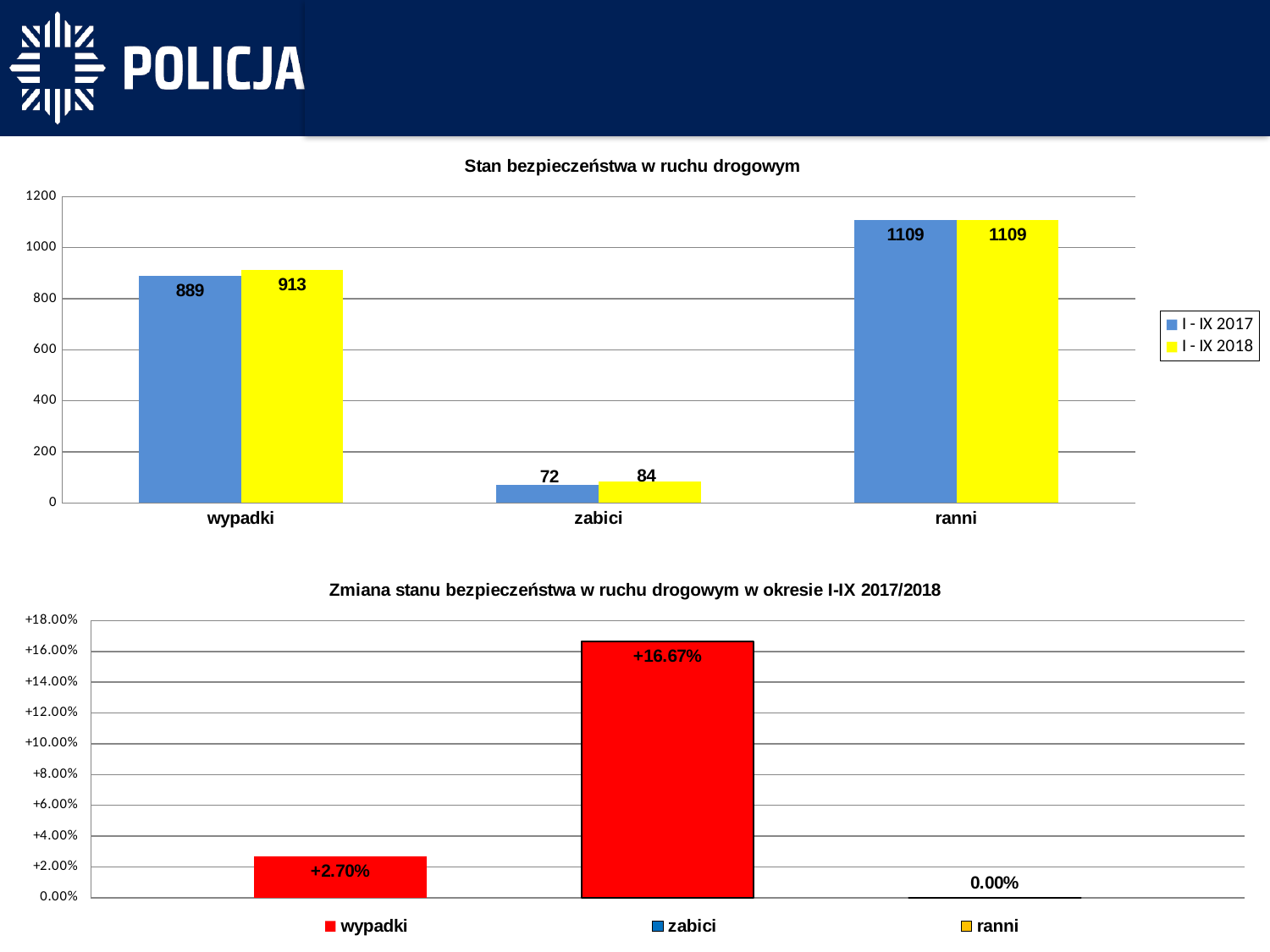
In the chart titled 'Stan bezpieczeństwa w ruchu drogowym', which category has the lowest value in the 'I - IX 2018' series? zabici In the chart titled 'Stan bezpieczeństwa w ruchu drogowym', which category has the highest value in the 'I - IX 2017' series? ranni In the chart titled 'Stan bezpieczeństwa w ruchu drogowym', what is the value for 'zabici' in the 'I - IX 2018' series? 84 In the chart titled 'Stan bezpieczeństwa w ruchu drogowym', how many categories are shown on the x axis? 3 What kind of chart is the chart titled 'Zmiana stanu bezpieczeństwa w ruchu drogowym w okresie I-IX 2017/2018'? bar chart In the chart titled 'Zmiana stanu bezpieczeństwa w ruchu drogowym w okresie I-IX 2017/2018', what is the value for 'wypadki'? +2.70% In the chart titled 'Stan bezpieczeństwa w ruchu drogowym', how many series does the legend list? 2 In the chart titled 'Stan bezpieczeństwa w ruchu drogowym', what is the difference between the 'I - IX 2018' and 'I - IX 2017' values for 'wypadki'? 24 In the chart titled 'Zmiana stanu bezpieczeństwa w ruchu drogowym w okresie I-IX 2017/2018', what is the value for 'zabici'? +16.67% In the chart titled 'Zmiana stanu bezpieczeństwa w ruchu drogowym w okresie I-IX 2017/2018', which category has the highest value? zabici In the chart titled 'Stan bezpieczeństwa w ruchu drogowym', what is the value for 'wypadki' in the 'I - IX 2017' series? 889 In the chart titled 'Stan bezpieczeństwa w ruchu drogowym', what is the value for 'ranni' in the 'I - IX 2017' series? 1109